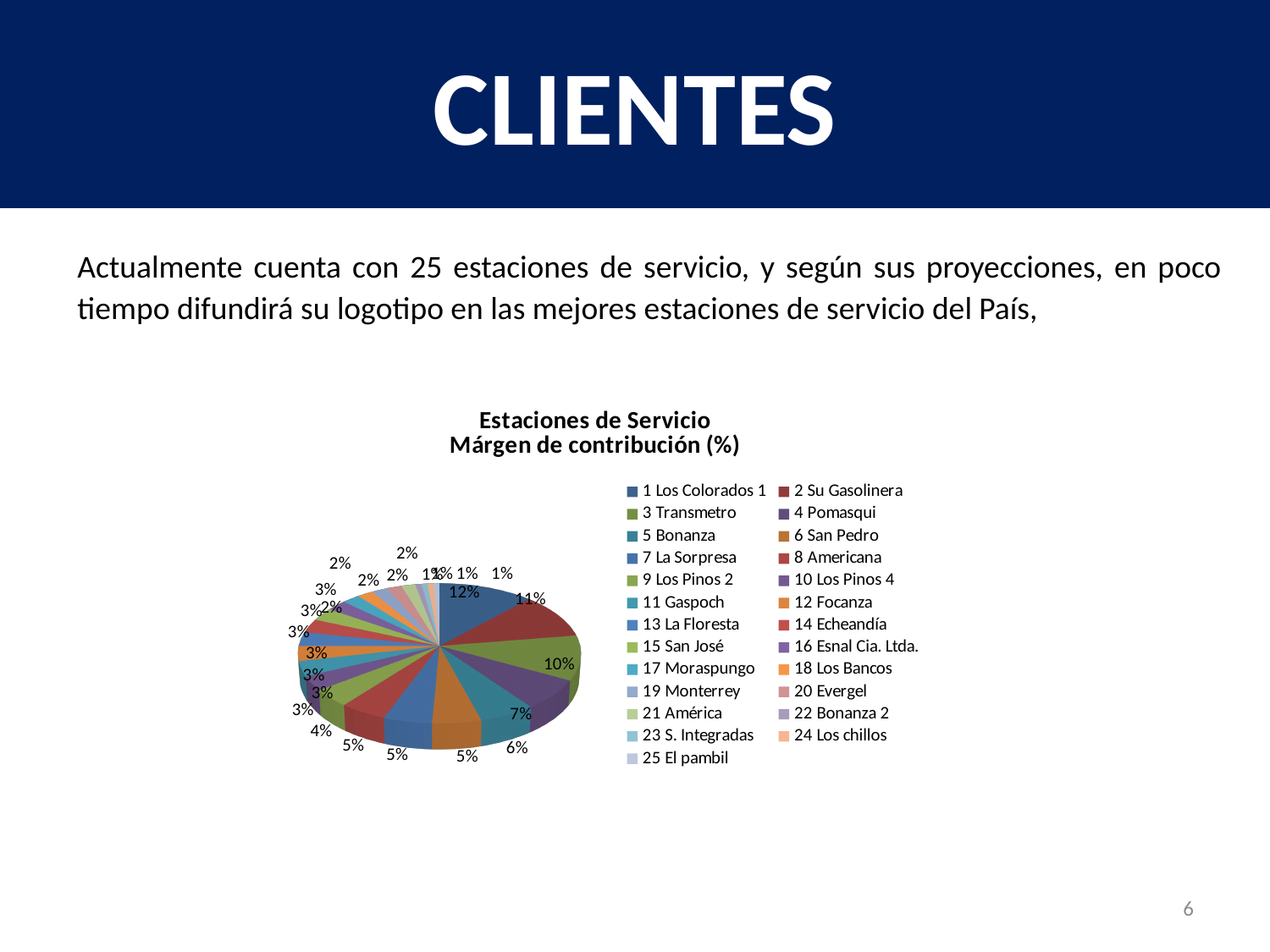
What is the difference between the shares of 1 Los Colorados 1 and 3 Transmetro? 2 percentage points Which station has the largest slice of the pie? 1 Los Colorados 1 Which has the larger share, 4 Pomasqui or 5 Bonanza? 4 Pomasqui What is the value shown for 2 Su Gasolinera? 11% What is the value shown for 4 Pomasqui? 7% What is the title of the chart? Estaciones de Servicio Márgen de contribución (%) What is the value shown for 3 Transmetro? 10% How many entries does the chart legend list? 25 What is the value shown for 5 Bonanza? 6% What is the difference between the shares of 2 Su Gasolinera and 4 Pomasqui? 4 percentage points What kind of chart is shown on the slide? Pie chart What share of the pie does 1 Los Colorados 1 represent? 12%